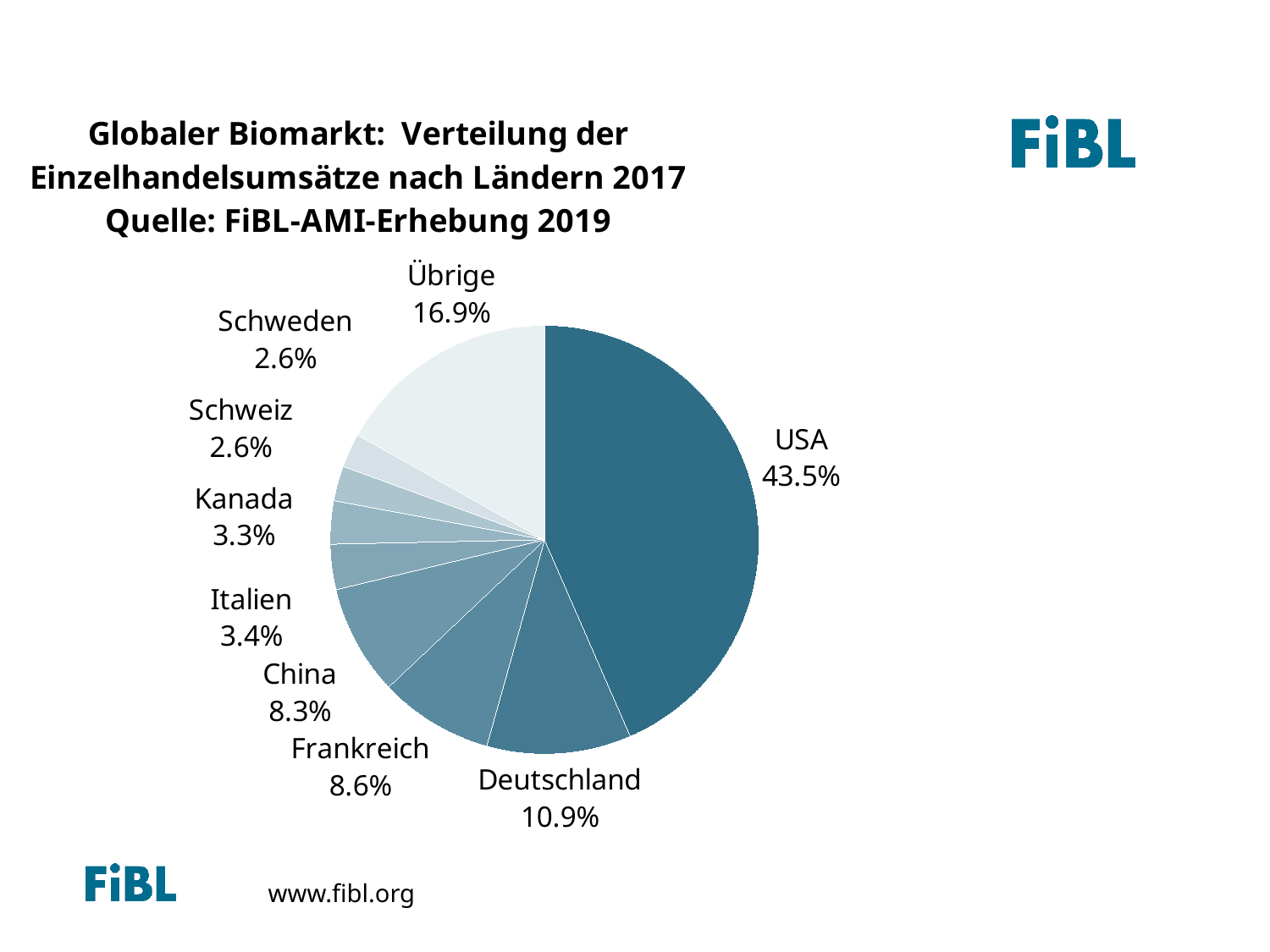
Which country has the largest slice of the pie chart? USA Which of the labelled slices is the smallest? Schweden and Schweiz (2.6% each) What percentage is shown for Frankreich? 8.6% What is the value shown for Deutschland in the pie chart? 10.9% Which is larger, the share for China or the share for Frankreich? Frankreich What share is labelled for Übrige? 16.9% What share of the global organic retail sales does the USA hold in the pie chart? 43.5% How many slices does the pie chart have? 9 What is the combined share of Kanada and Italien? 6.7% What source is cited in the chart title? FiBL-AMI-Erhebung 2019 What is the difference in percentage points between the USA and Deutschland? 32.6 What type of chart is shown on the slide? Pie chart